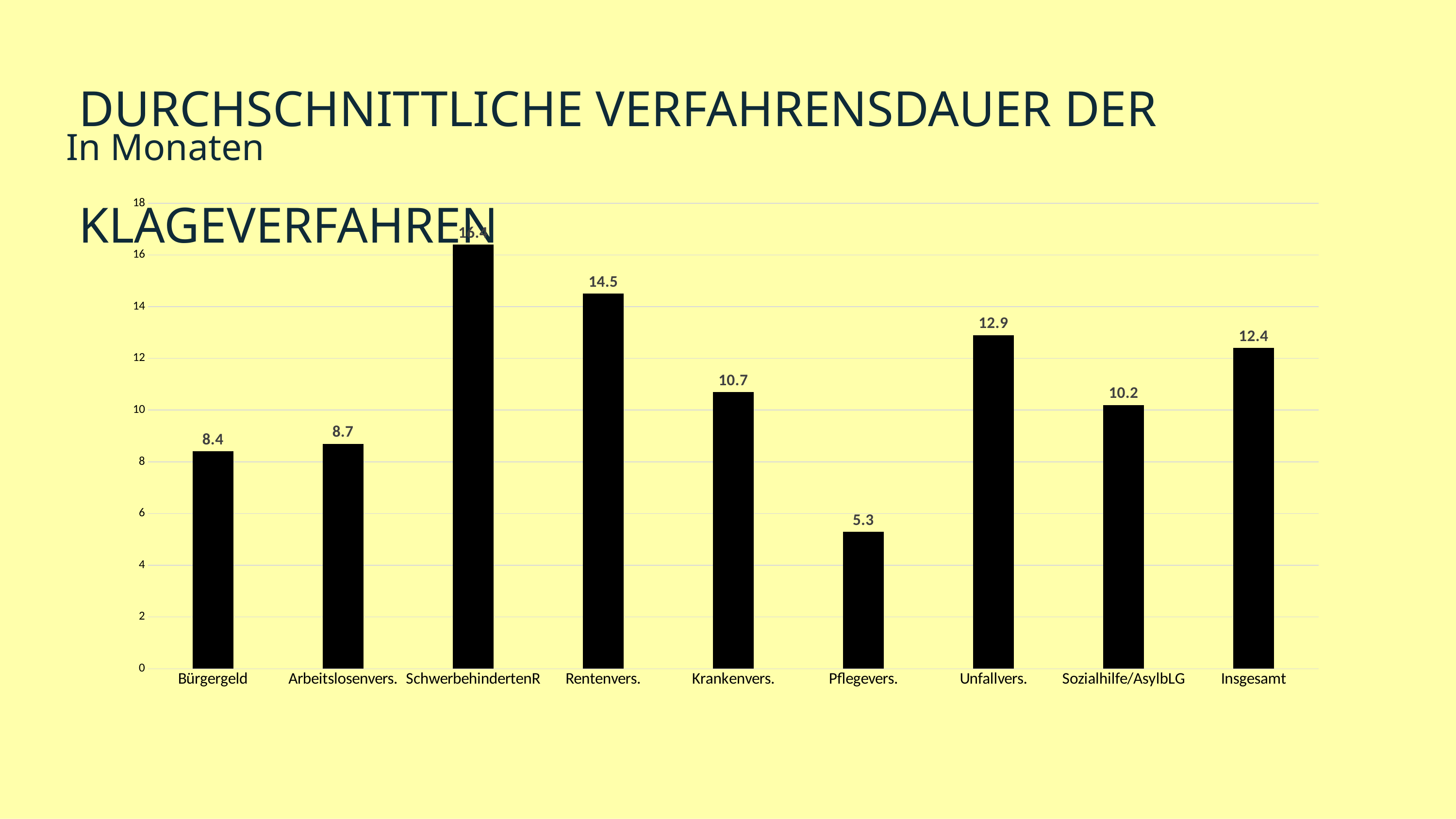
What is the value for Bürgergeld? 8.4 What is the value for Rentenvers.? 14.5 Which is larger, the value for Unfallvers. or the value for Sozialhilfe/AsylbLG? Unfallvers. What is the value for Insgesamt? 12.4 How many categories are shown on the x axis? 9 What kind of chart is shown on the slide? bar chart Which category has the lowest value? Pflegevers. What is the difference between the values for Rentenvers. and Krankenvers.? 3.8 Is the value for SchwerbehindertenR greater or less than 14? greater Which category has the highest value? SchwerbehindertenR In what unit are the values given, according to the subtitle? Monaten What is the value for Pflegevers.? 5.3